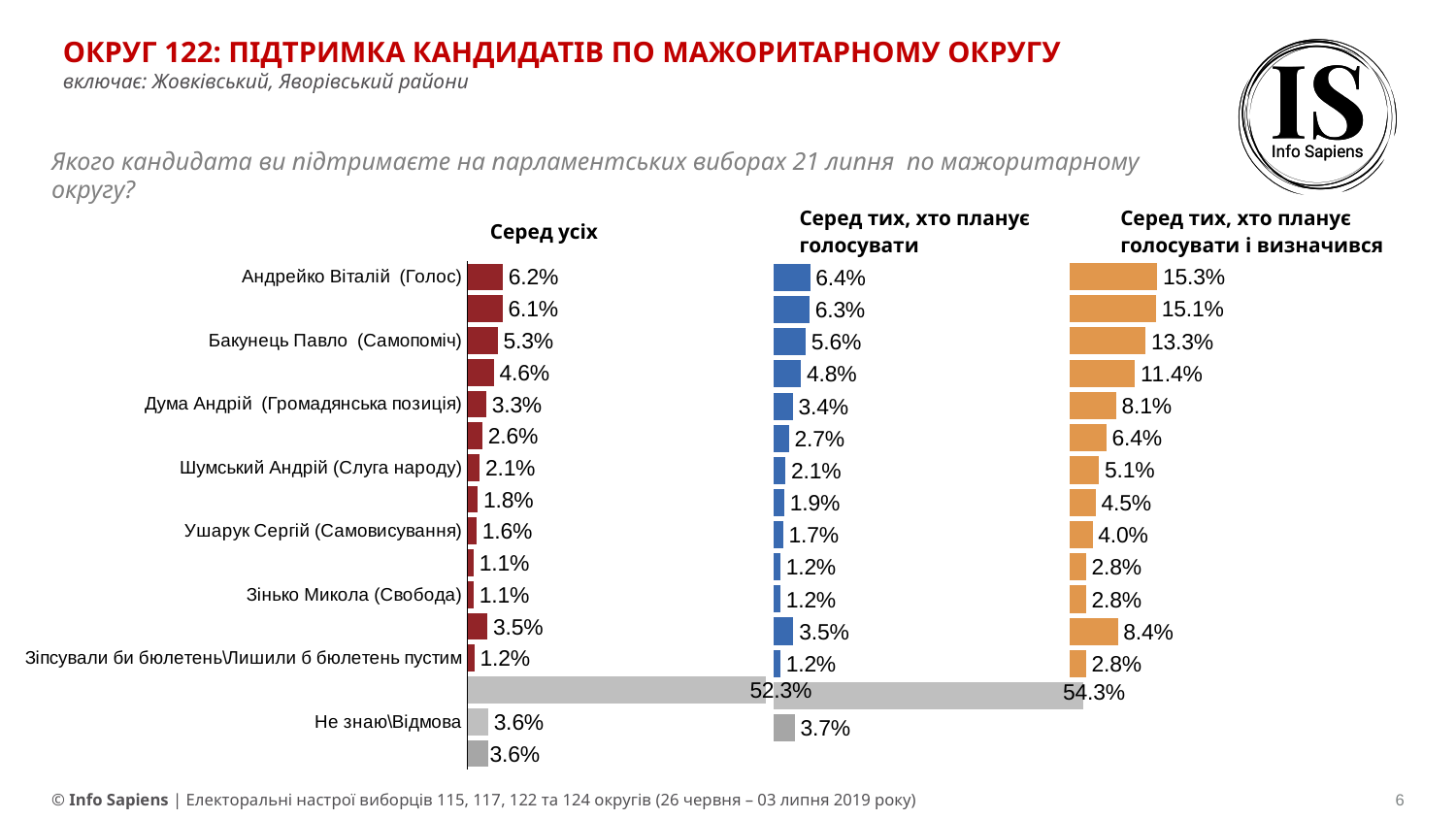
In the "Серед усіх" chart, what is the difference between the values for Андрейко Віталій (Голос) and Бакунець Павло (Самопоміч)? 0.9% In the "Серед тих, хто планує голосувати і визначився" chart, what is the value for Бакунець Павло (Самопоміч)? 13.3% In the "Серед тих, хто планує голосувати і визначився" chart, what is the difference between the values for Андрейко Віталій (Голос) and Дума Андрій (Громадянська позиція)? 7.2% In the "Серед тих, хто планує голосувати і визначився" chart, which named candidate has the highest value? Андрейко Віталій (Голос) How many separate charts are shown on the slide? 3 In the "Серед усіх" chart, what is the value for Шумський Андрій (Слуга народу)? 2.1% In the "Серед усіх" chart, what is the value for Андрейко Віталій (Голос)? 6.2% In the "Серед тих, хто планує голосувати" chart, what is the value for Дума Андрій (Громадянська позиція)? 3.4% In the "Серед тих, хто планує голосувати і визначився" chart, what is the value for Ушарук Сергій (Самовисування)? 4.0% What kind of chart is used on this slide? Bar chart In the "Серед тих, хто планує голосувати" chart, which is larger: the value for Бакунець Павло (Самопоміч) or the value for Шумський Андрій (Слуга народу)? Бакунець Павло (Самопоміч) In the "Серед тих, хто планує голосувати" chart, what is the value for Не знаю\Відмова? 3.7%